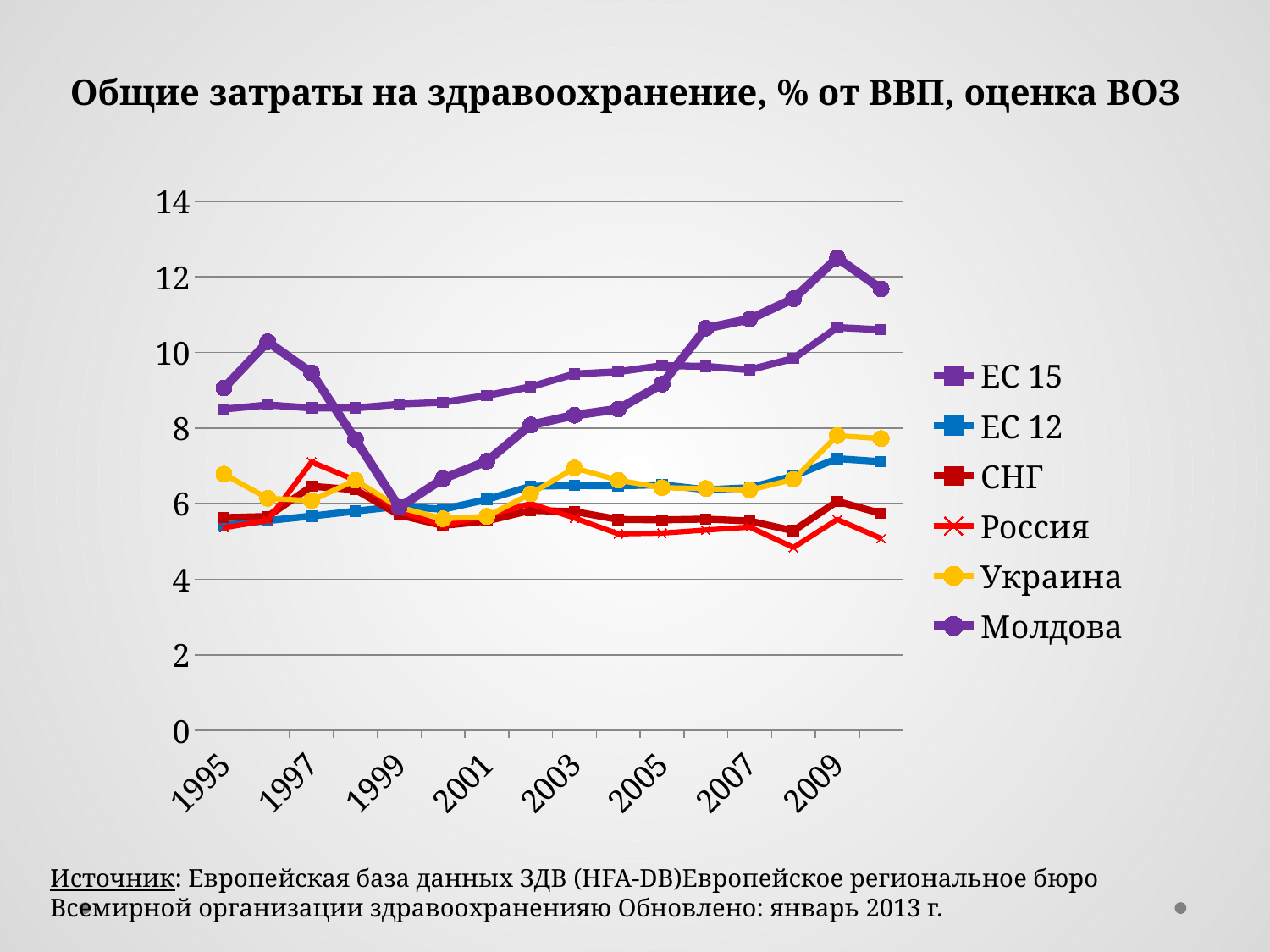
Which series has the highest value in 2009? Молдова Which is larger in 2009, the value for Украина or the value for Россия? Украина Is the value for ЕС 15 in 1995 greater or less than 8? greater Which series has the lowest value in 2009? Россия What kind of chart is shown on the slide? line chart Which series is plotted with a yellow line and circle markers? Украина What is the title of the chart? Общие затраты на здравоохранение, % от ВВП, оценка ВОЗ Is the value for Россия in 2008 greater or less than 6? less How many series does the legend list? 6 Does the ЕС 15 line rise or fall overall from 1995 to the end of the period? rise Is the value for Молдова in 2009 greater or less than 12? greater